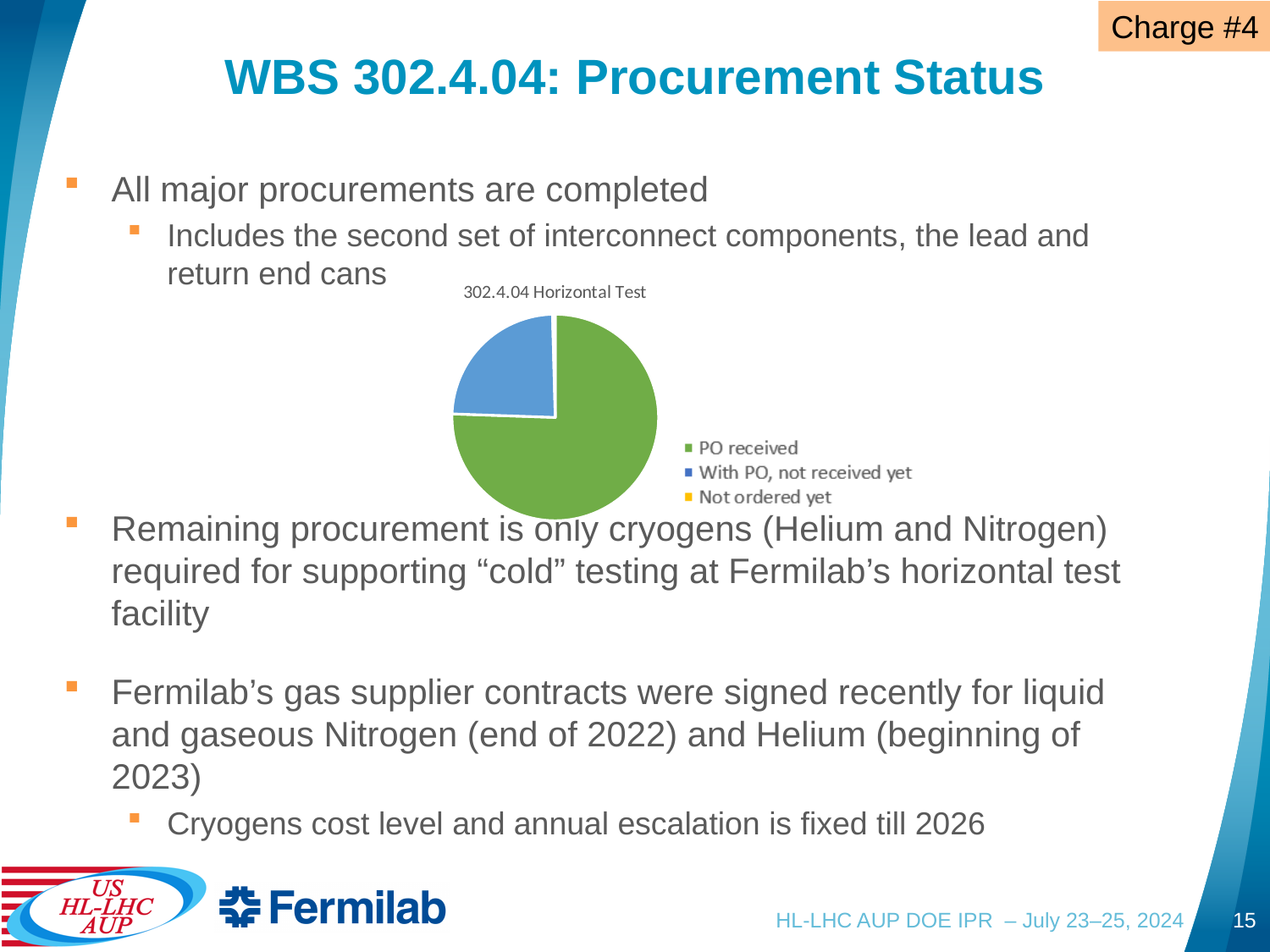
Which is larger in the pie chart: the slice for PO received or the slice for With PO, not received yet? PO received Which category has the largest slice in the pie chart? PO received How many entries does the legend of the pie chart list? 3 How many slices are visible in the pie chart? 2 What colour represents PO received in the pie chart? Green Which legend category of the pie chart has no visible slice? Not ordered yet What is the title of the pie chart? 302.4.04 Horizontal Test What kind of chart is shown on the slide? Pie chart